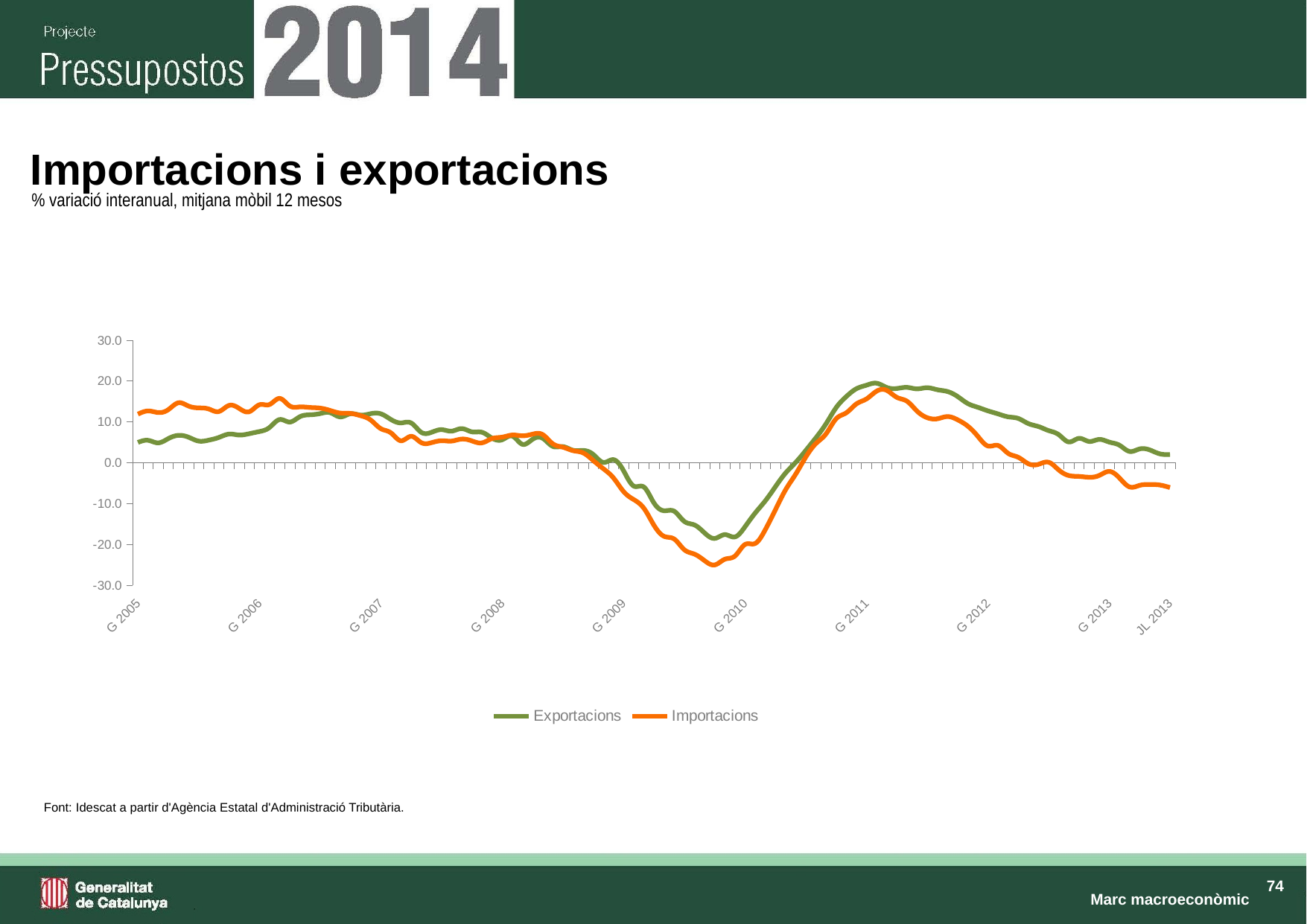
At JL 2013, which series has the higher value, Exportacions or Importacions? Exportacions What kind of chart is shown on the slide? line chart What is the title of the chart on the slide? Importacions i exportacions How many labels are shown on the x axis? 10 At G 2005, which series has the higher value, Exportacions or Importacions? Importacions Is the value for Exportacions at G 2011 greater or less than 10.0? greater Does the Exportacions series rise or fall between G 2011 and JL 2013? fall Is the value for Importacions at JL 2013 greater or less than 0.0? less Is the value for Exportacions at G 2010 greater or less than -10.0? less How many series does the legend list? 2 Which colour is used for the Importacions series? orange